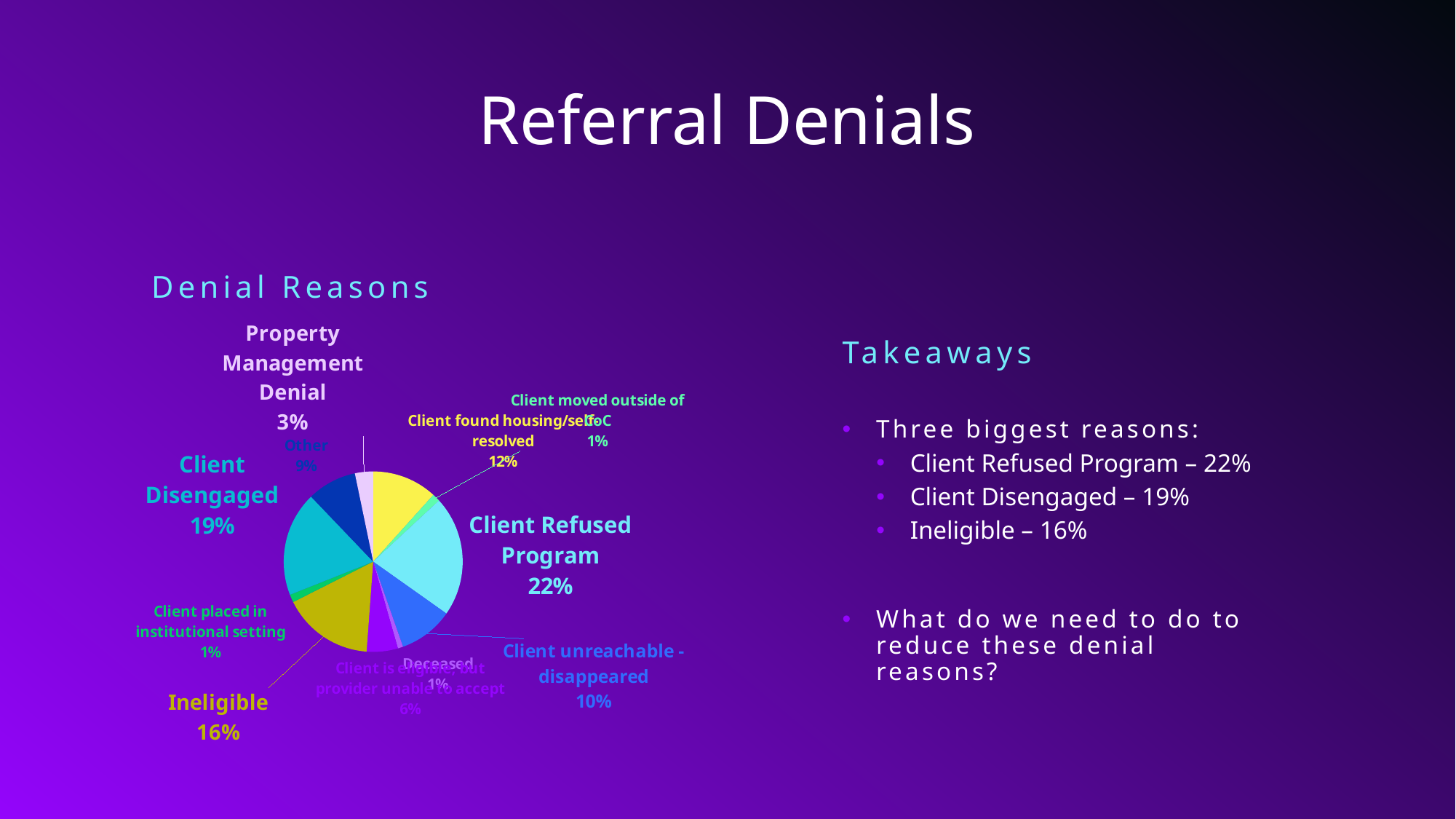
What percentage of denials is attributed to Client Refused Program? 22% What is the combined share of Client Refused Program, Client Disengaged and Ineligible? 57% What percentage of denials is attributed to Client found housing/self-resolved? 12% What percentage of denials is attributed to Client Disengaged? 19% What percentage of denials is attributed to Property Management Denial? 3% What is the difference in percentage points between Client Refused Program and Ineligible? 6 What percentage of denials is attributed to Ineligible? 16% What percentage of denials is attributed to Client unreachable - disappeared? 10% Which denial reason has the largest share of the pie? Client Refused Program What is the title of the pie chart? Denial Reasons What type of chart is shown under "Denial Reasons"? pie chart Which is larger: the share for Client Disengaged or the share for Client unreachable - disappeared? Client Disengaged